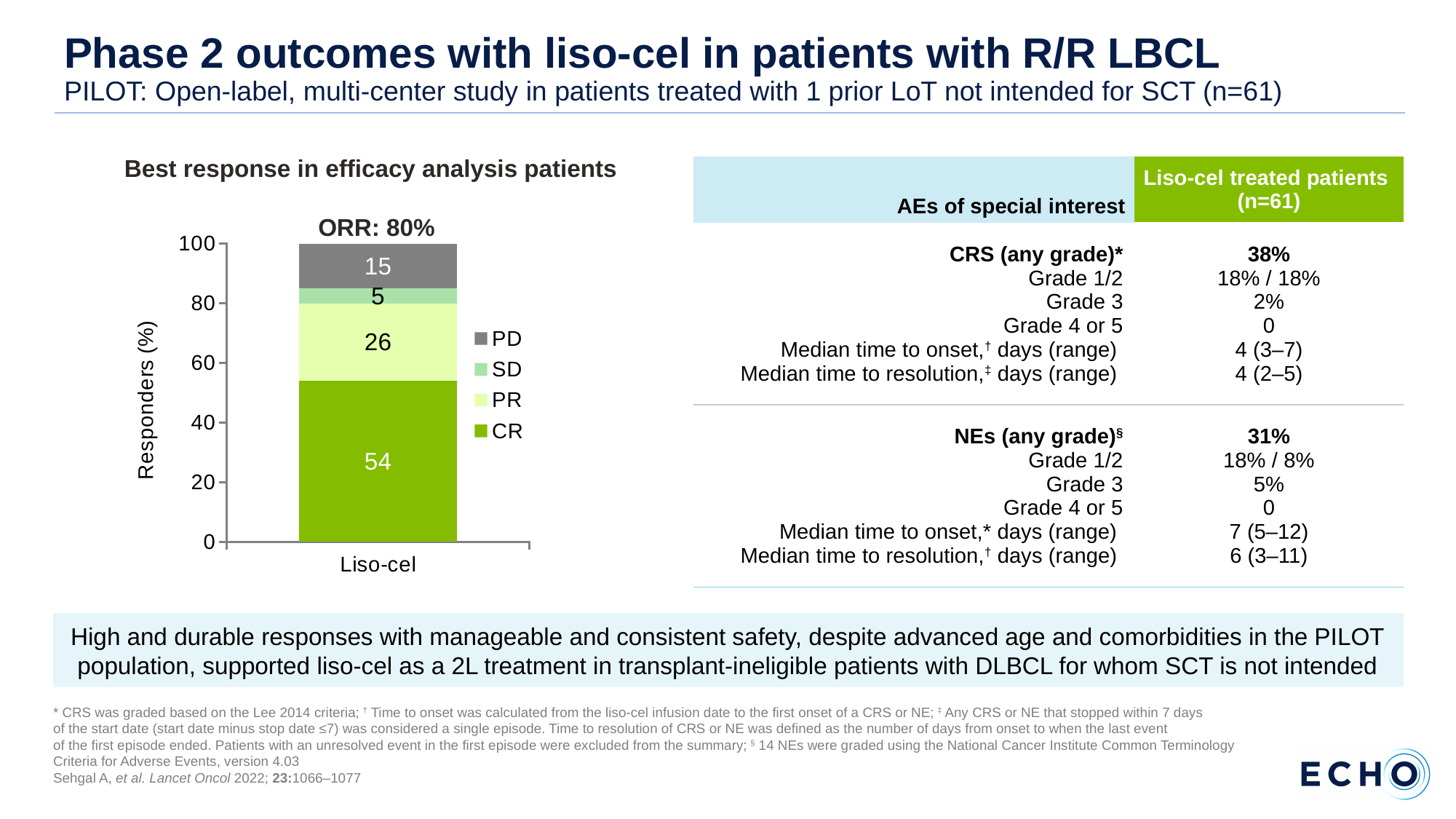
What is the value for SD in the Liso-cel bar? 5 What is the difference between the CR and PR values in the Liso-cel bar? 28 Which response category has the largest segment in the Liso-cel bar? CR What is the value for PD in the Liso-cel bar? 15 What ORR is shown above the Liso-cel bar? 80% Which is larger in the Liso-cel bar, PD or SD? PD What is the value for PR in the Liso-cel bar? 26 What is the total of the Liso-cel stacked bar? 100 How many series does the chart legend list? 4 Which response category has the smallest segment in the Liso-cel bar? SD What is the value for CR in the Liso-cel bar? 54 What kind of chart is shown under "Best response in efficacy analysis patients"? Stacked bar chart